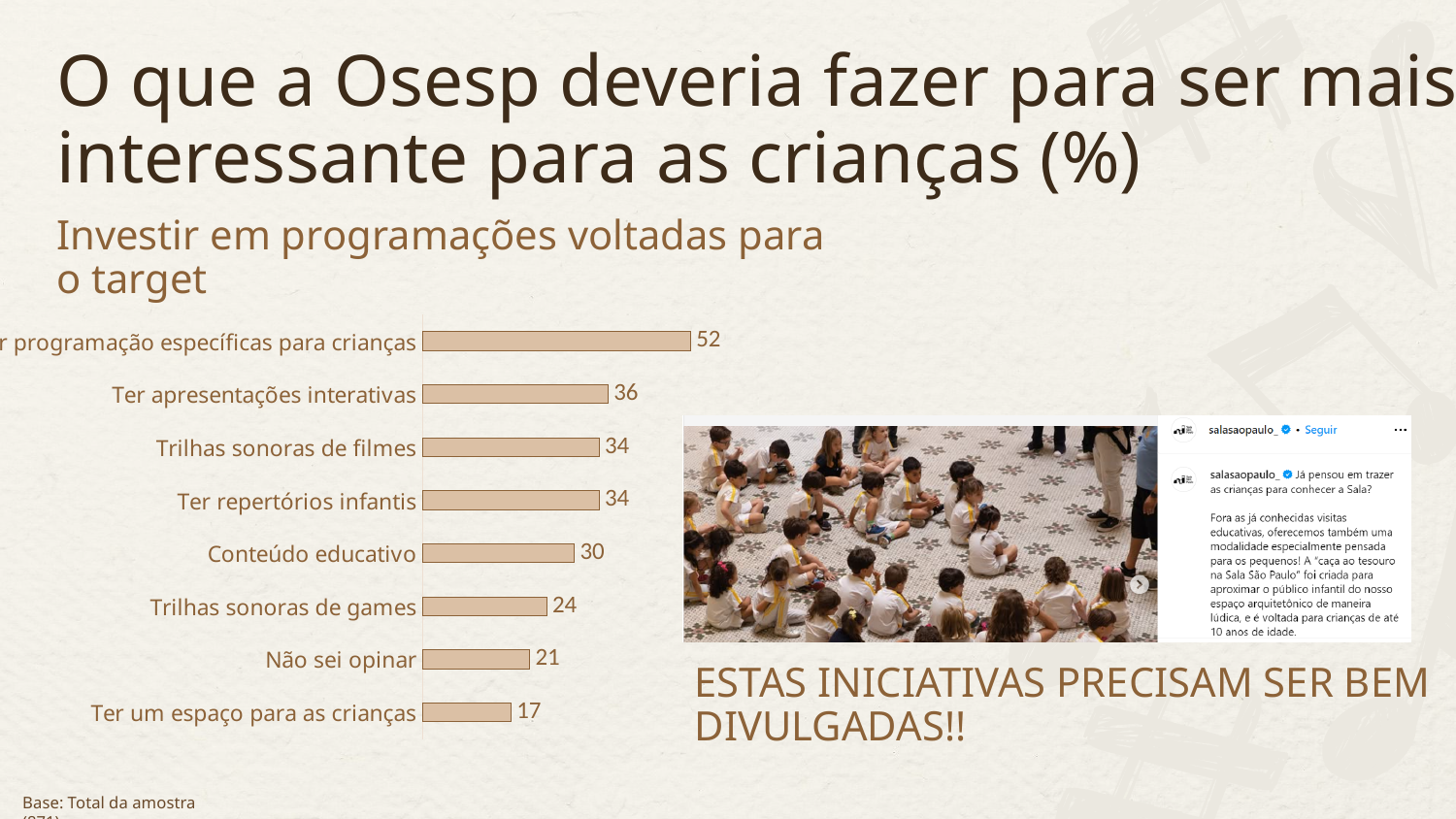
What is the highest value shown in the chart? 52 Which category has the lowest value in the chart? Ter um espaço para as crianças What value is shown for "Ter apresentações interativas"? 36 What value is shown for "Trilhas sonoras de games"? 24 What is the difference between the values for "Ter apresentações interativas" and "Ter um espaço para as crianças"? 19 What value is shown for "Não sei opinar"? 21 What value is shown for "Conteúdo educativo"? 30 What type of chart is shown on the slide? Bar chart Do "Trilhas sonoras de filmes" and "Ter repertórios infantis" have the same value? Yes, both are 34 What is the subtitle shown above the chart? Investir em programações voltadas para o target Which is larger, the value for "Conteúdo educativo" or the value for "Trilhas sonoras de games"? Conteúdo educativo How many categories are shown in the bar chart? 8